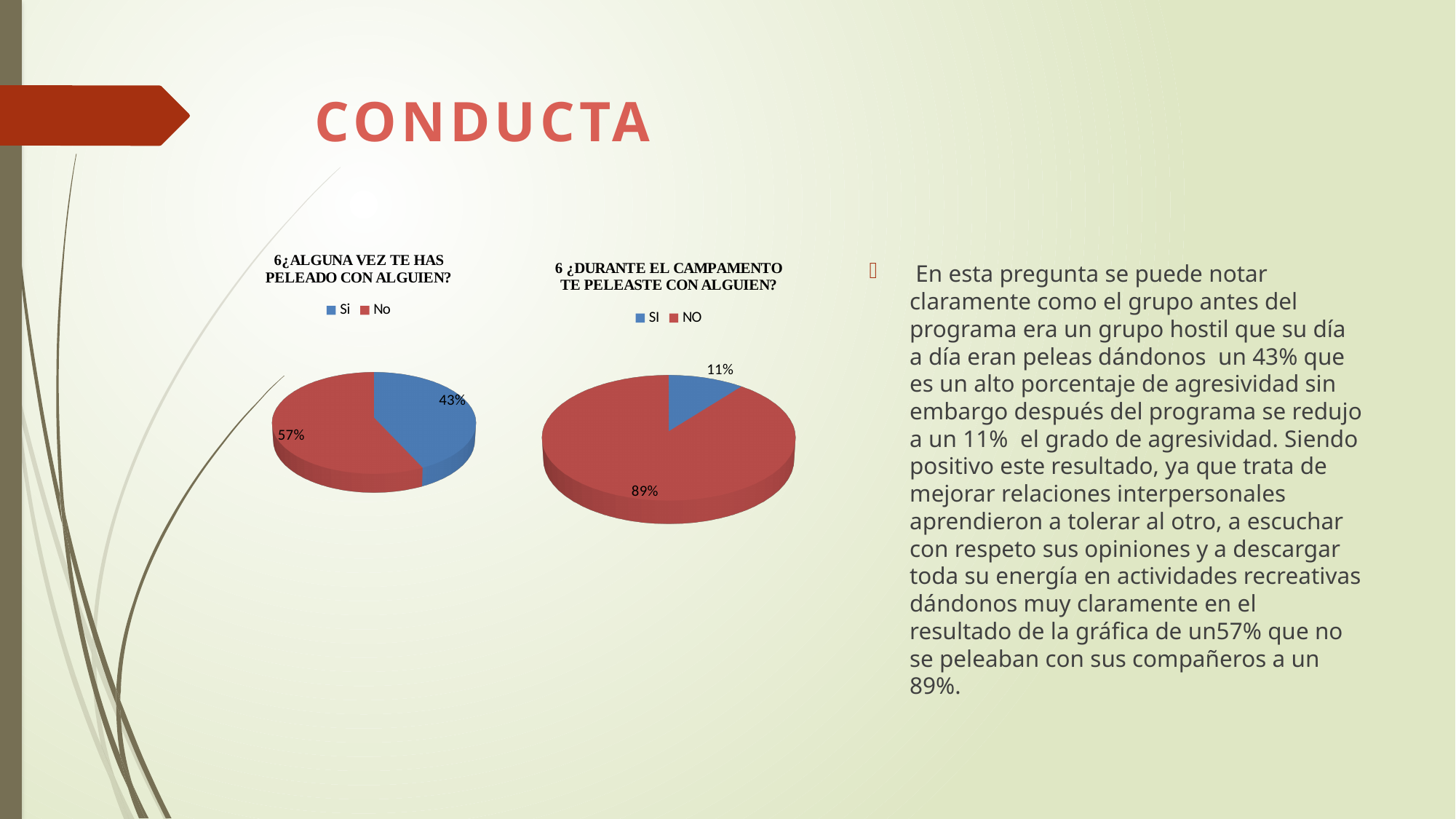
In the right pie chart, what is the difference in percentage points between "NO" and "SI"? 78 Is the "Si" share in the left pie chart larger or smaller than the "SI" share in the right pie chart? larger In the left pie chart titled "6¿ALGUNA VEZ TE HAS PELEADO CON ALGUIEN?", what percentage is shown for "No"? 57% In the left pie chart, what colour represents "No"? Red How many categories does the legend of the right pie chart list? 2 In the right pie chart titled "6 ¿DURANTE EL CAMPAMENTO TE PELEASTE CON ALGUIEN?", what percentage is shown for "SI"? 11% In the right pie chart titled "6 ¿DURANTE EL CAMPAMENTO TE PELEASTE CON ALGUIEN?", what percentage is shown for "NO"? 89% In the left pie chart, what is the difference in percentage points between "No" and "Si"? 14 In the left pie chart titled "6¿ALGUNA VEZ TE HAS PELEADO CON ALGUIEN?", what percentage is shown for "Si"? 43% In the right pie chart, which category has the smaller share? SI What type of chart is used on the left of the slide? Pie chart In the left pie chart, which category has the larger share? No